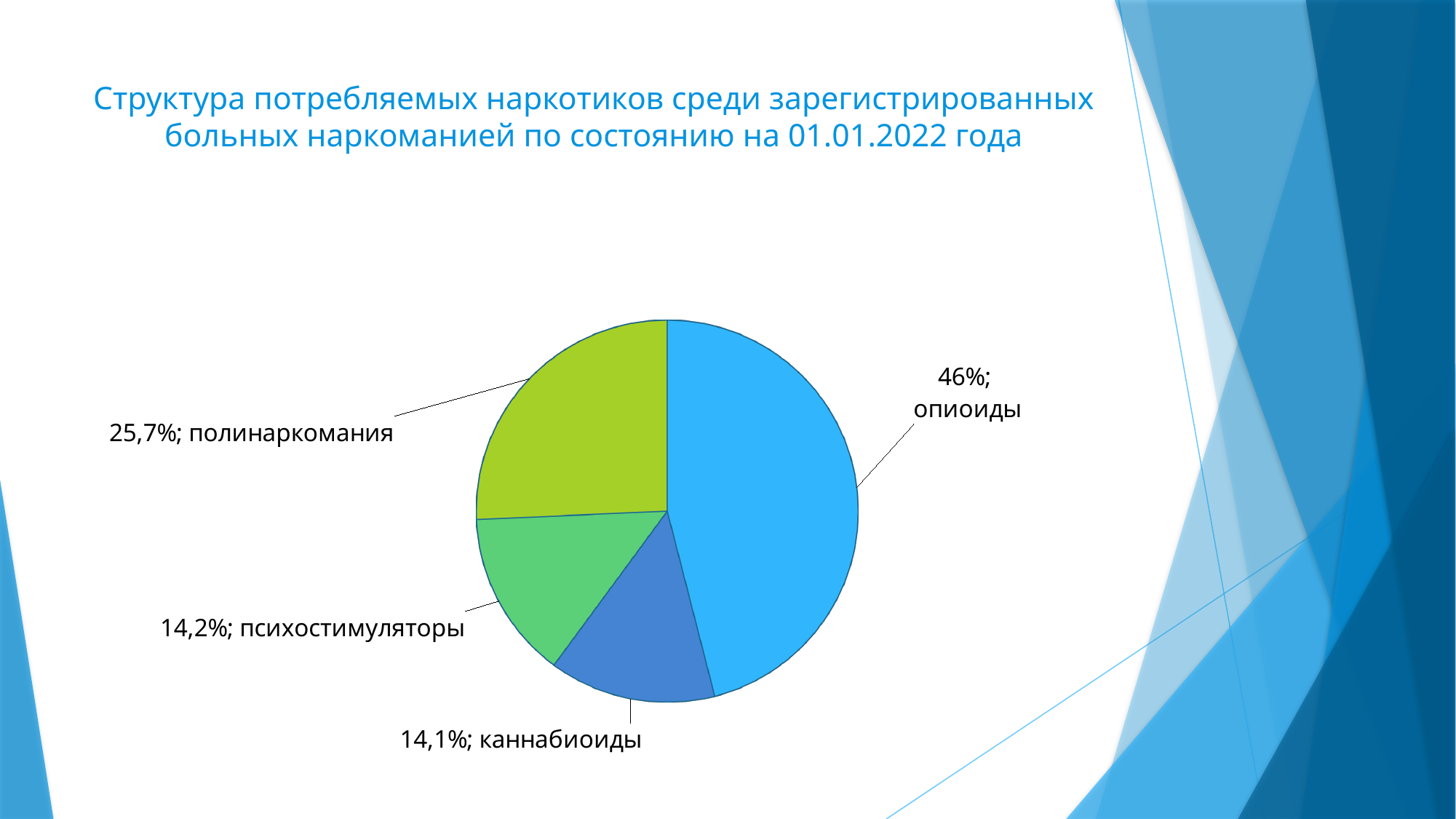
What is the value shown for каннабиоиды? 14,1% What is the value shown for полинаркомания? 25,7% Which category has the largest slice of the pie? опиоиды What colour is the slice for опиоиды? light blue What is the difference in percentage points between полинаркомания and психостимуляторы? 11,5% What share of the pie does опиоиды account for? 46% What is the difference in percentage points between опиоиды and полинаркомания? 20,3% Which is larger, the slice for опиоиды or the slice for полинаркомания? опиоиды How many slices does the pie chart have? 4 What is the value shown for психостимуляторы? 14,2% What kind of chart is shown on the slide? pie chart Which is larger, the slice for полинаркомания or the slice for каннабиоиды? полинаркомания